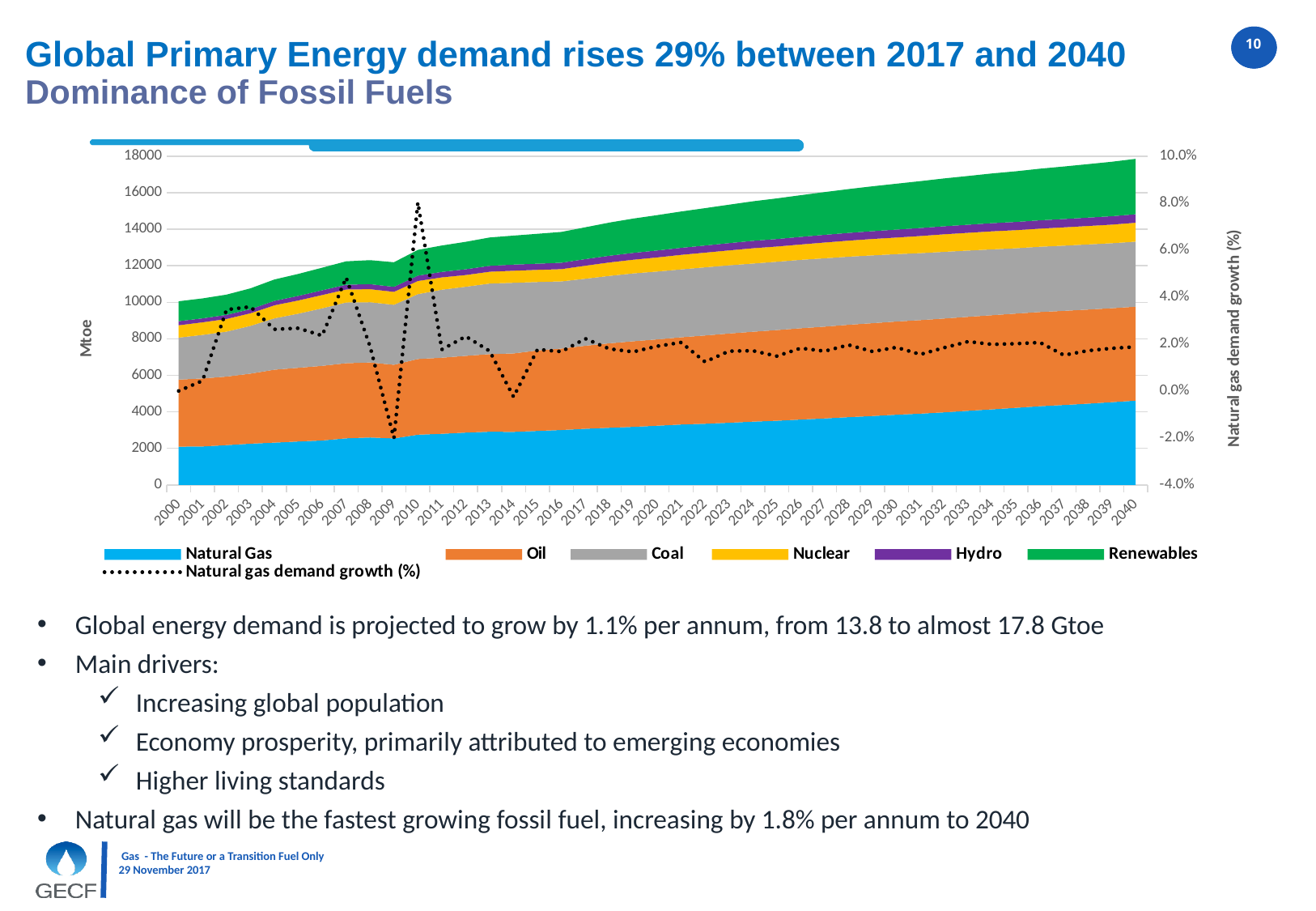
In 2040, which layer is larger: Oil or Nuclear? Oil Is the natural gas demand growth in 2009 greater or less than 0.0%? less How many series does the legend list? 7 Does total primary energy demand rise or fall from 2000 to 2040? Rise Is the natural gas demand growth in 2010 greater or less than 6.0%? greater In which year does the natural gas demand growth line reach its highest point? 2010 What is the label of the left vertical axis? Mtoe Is the total energy demand in 2000 greater or less than 12000 Mtoe? less How many years are shown along the x axis? 41 What kind of chart is shown on the slide? Stacked area chart with a dotted line series In which year does the natural gas demand growth line reach its lowest point? 2009